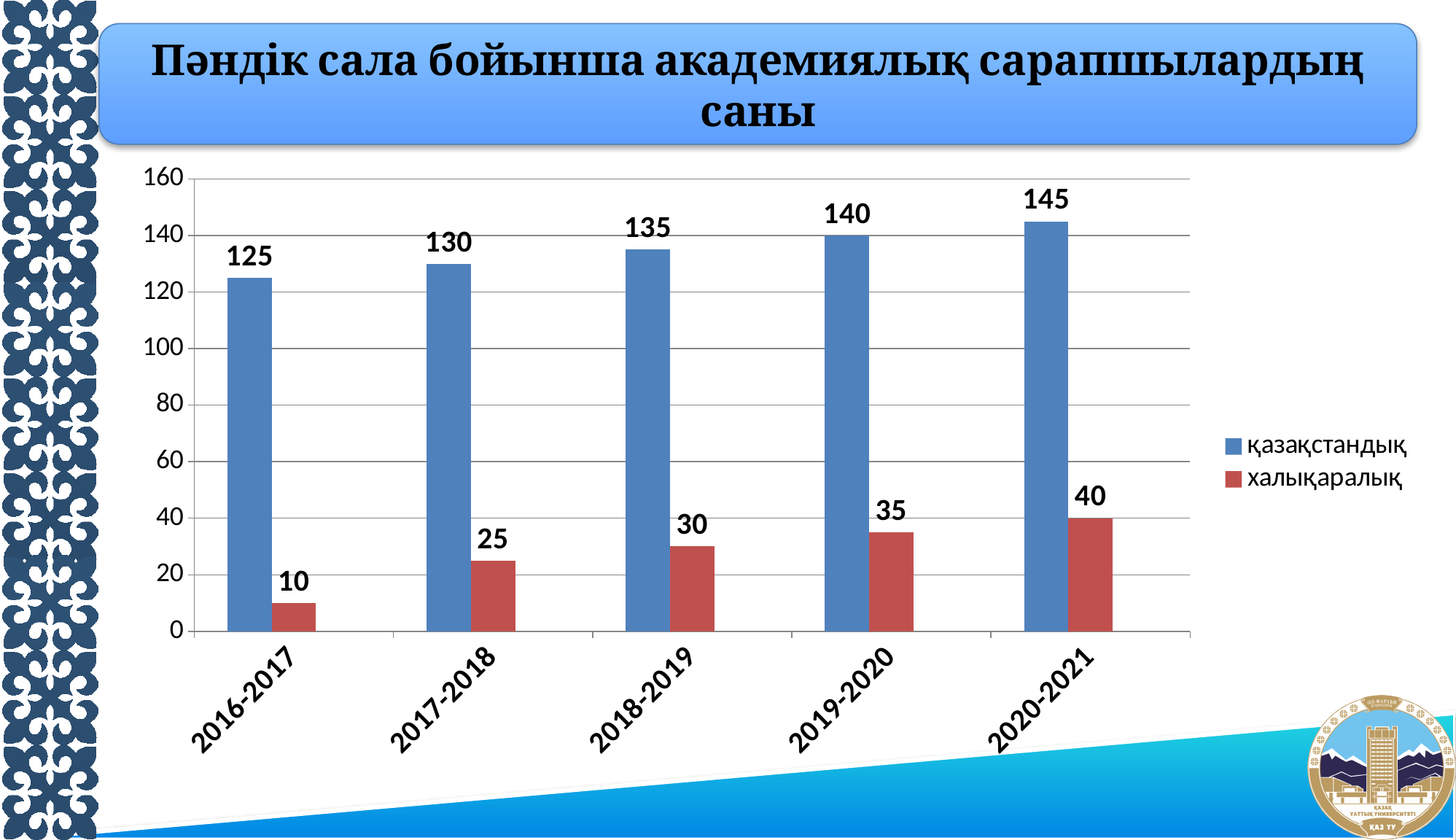
What is the value for қазақстандық in 2016-2017? 125 What is the difference between the қазақстандық and халықаралық values in 2020-2021? 105 In which year is the қазақстандық value highest? 2020-2021 How many series does the legend list? 2 By how much did the халықаралық value increase from 2016-2017 to 2020-2021? 30 What is the value for халықаралық in 2019-2020? 35 How many year categories are shown on the x axis? 5 What is the value for халықаралық in 2017-2018? 25 Do the халықаралық values rise or fall from 2016-2017 to 2020-2021? rise In which year is the халықаралық value lowest? 2016-2017 What kind of chart is shown on the slide? bar chart Which is larger in 2018-2019: қазақстандық or халықаралық? қазақстандық